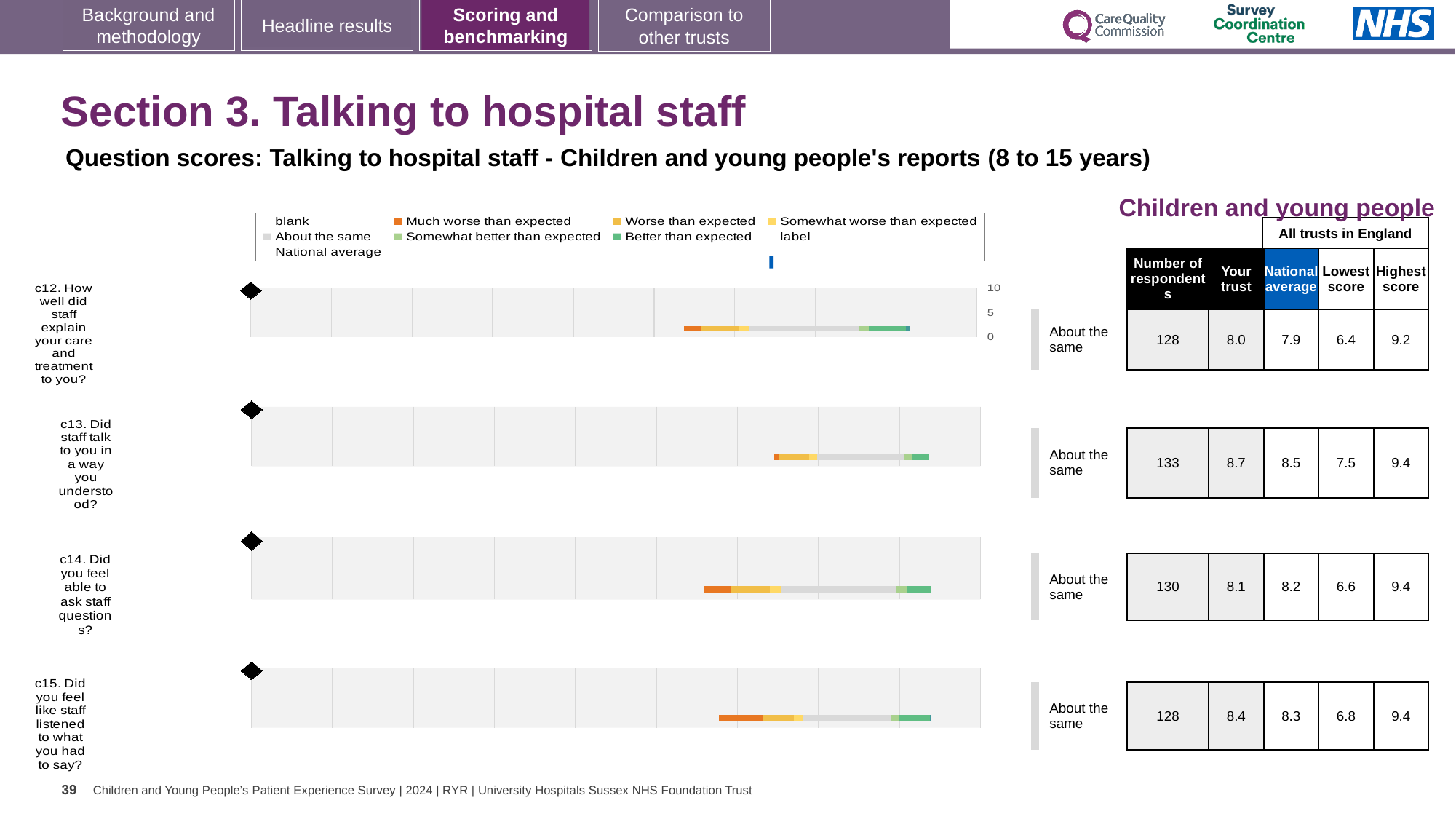
What kind of chart is used to show the benchmark bands for each question? Bar chart Which question has the lowest 'Your trust' score? c12. How well did staff explain your care and treatment to you? Which question has the highest 'Your trust' score? c13. Did staff talk to you in a way you understood? What benchmark category is shown for question c15? About the same What is the highest score among all trusts in England for question c15 (Did you feel like staff listened to what you had to say?)? 9.4 For question c14, which is larger: the 'Your trust' score or the national average? National average What is the national average score for question c12 (How well did staff explain your care and treatment to you?)? 7.9 How many questions are plotted on this slide? 4 What is the 'Your trust' score for question c13 (Did staff talk to you in a way you understood?)? 8.7 What is the difference between the 'Your trust' score and the national average for question c13? 0.2 Which legend entry is shown in orange? Much worse than expected How many respondents answered question c14 (Did you feel able to ask staff questions?)? 130